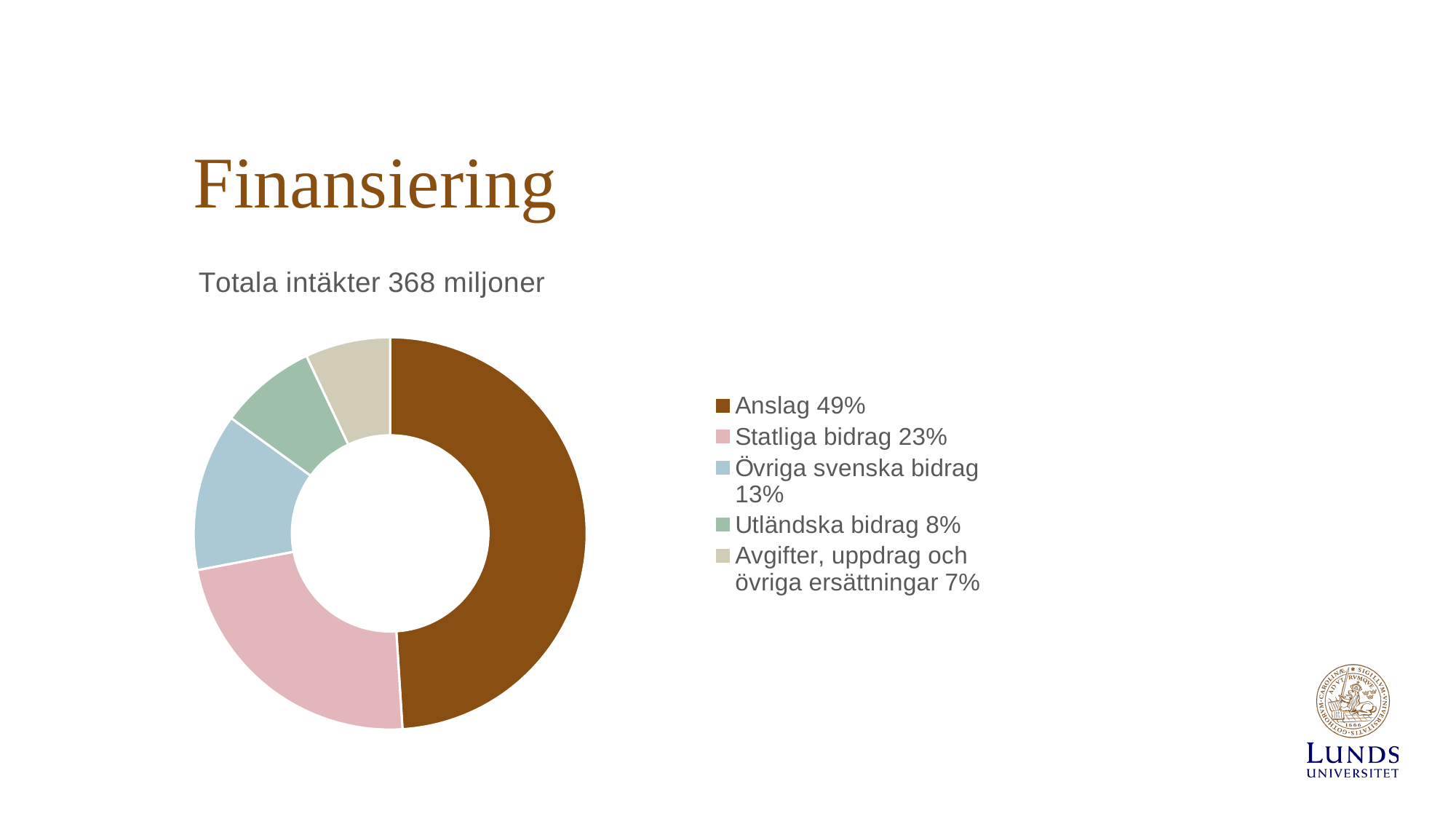
What percentage is shown for Utländska bidrag? 8% Which category has the smallest share of the chart? Avgifter, uppdrag och övriga ersättningar What is the difference in percentage points between Anslag and Statliga bidrag? 26 Which is larger, Övriga svenska bidrag or Utländska bidrag? Övriga svenska bidrag Which category has the largest share of the chart? Anslag What percentage is shown for Övriga svenska bidrag? 13% What kind of chart is shown on the slide? Donut (pie) chart What percentage is shown for Statliga bidrag? 23% What share of the donut chart does Anslag represent? 49% What percentage is shown for Avgifter, uppdrag och övriga ersättningar? 7% What total income is stated above the chart? 368 miljoner How many categories does the chart show? 5